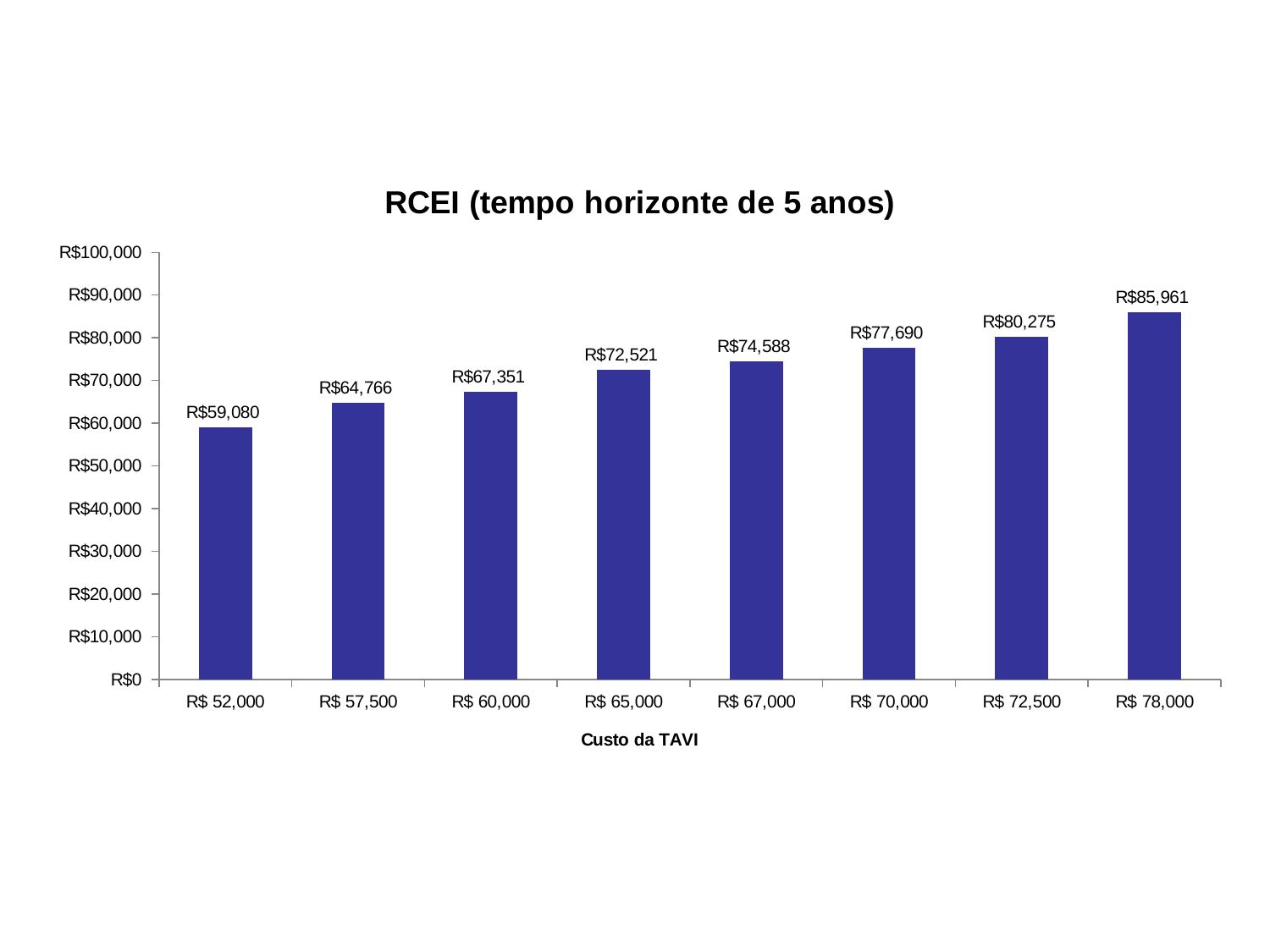
What is the RCEI value when the Custo da TAVI is R$ 65,000? R$72,521 What is the difference between the RCEI values for Custo da TAVI of R$ 78,000 and R$ 52,000? R$26,881 Is the RCEI value for Custo da TAVI of R$ 70,000 greater or less than R$70,000? greater Which has a larger RCEI value: Custo da TAVI of R$ 60,000 or R$ 67,000? R$ 67,000 What kind of chart is shown on the slide? Bar chart Do the RCEI values rise or fall as the Custo da TAVI increases along the x axis? Rise Which Custo da TAVI category has the lowest RCEI value? R$ 52,000 Which Custo da TAVI category has the highest RCEI value? R$ 78,000 What is the title of the chart? RCEI (tempo horizonte de 5 anos) What is the RCEI value when the Custo da TAVI is R$ 72,500? R$80,275 How many Custo da TAVI categories are shown on the chart? 8 What is the RCEI value when the Custo da TAVI is R$ 52,000? R$59,080